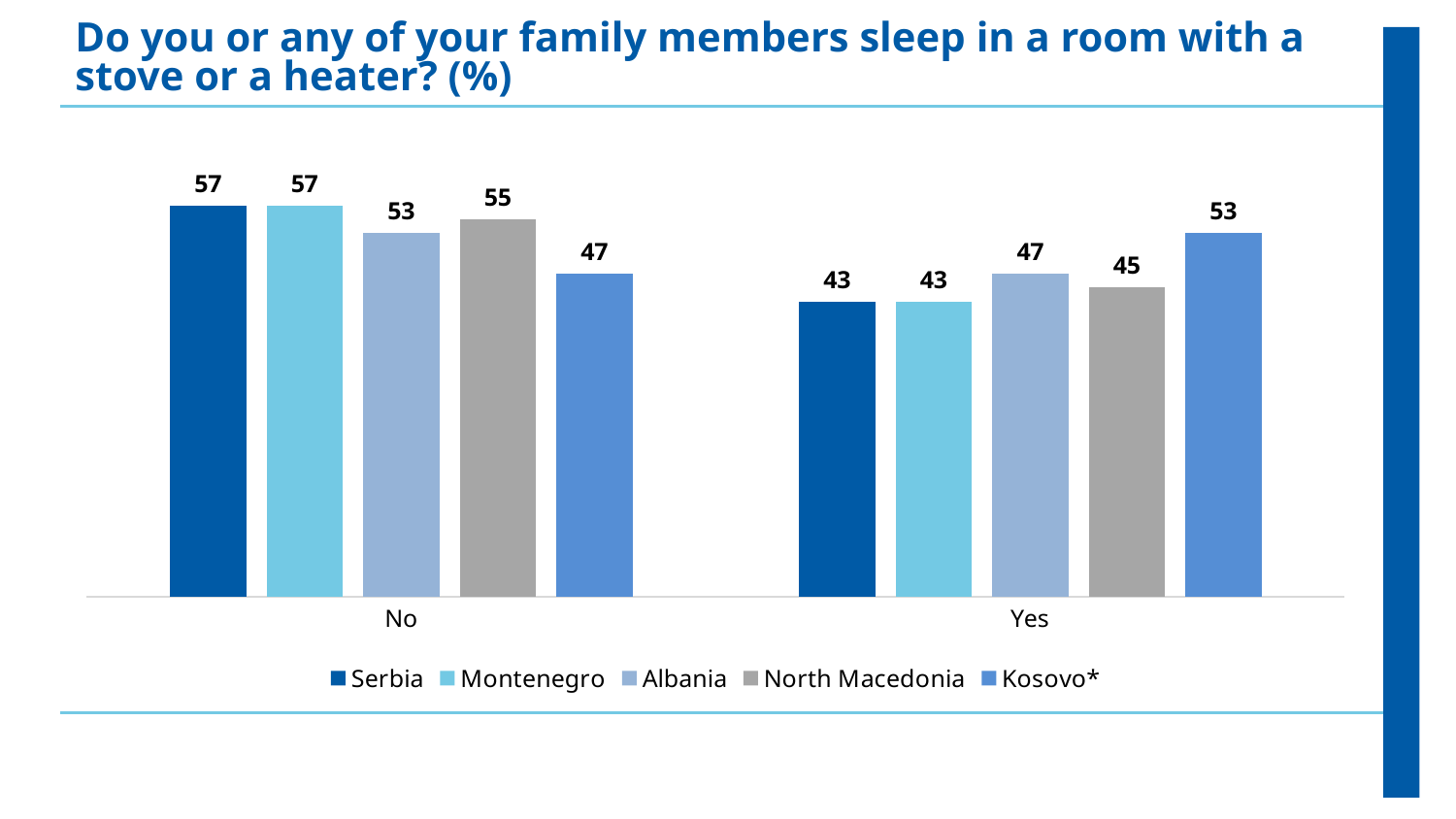
What kind of chart is shown on the slide? Bar chart What is the value for North Macedonia in the "No" category? 55 What is the title of the chart? Do you or any of your family members sleep in a room with a stove or a heater? (%) How many categories are shown on the x axis? 2 What is the value for Kosovo* in the "Yes" category? 53 What is the value for Serbia in the "No" category? 57 Which country has the highest value in the "Yes" category? Kosovo* What is the value for Albania in the "Yes" category? 47 What is the difference between the "No" and "Yes" values for Serbia? 14 Which is larger: the "Yes" value for North Macedonia or the "Yes" value for Albania? Albania Which country has the lowest value in the "No" category? Kosovo* How many series does the legend list? 5